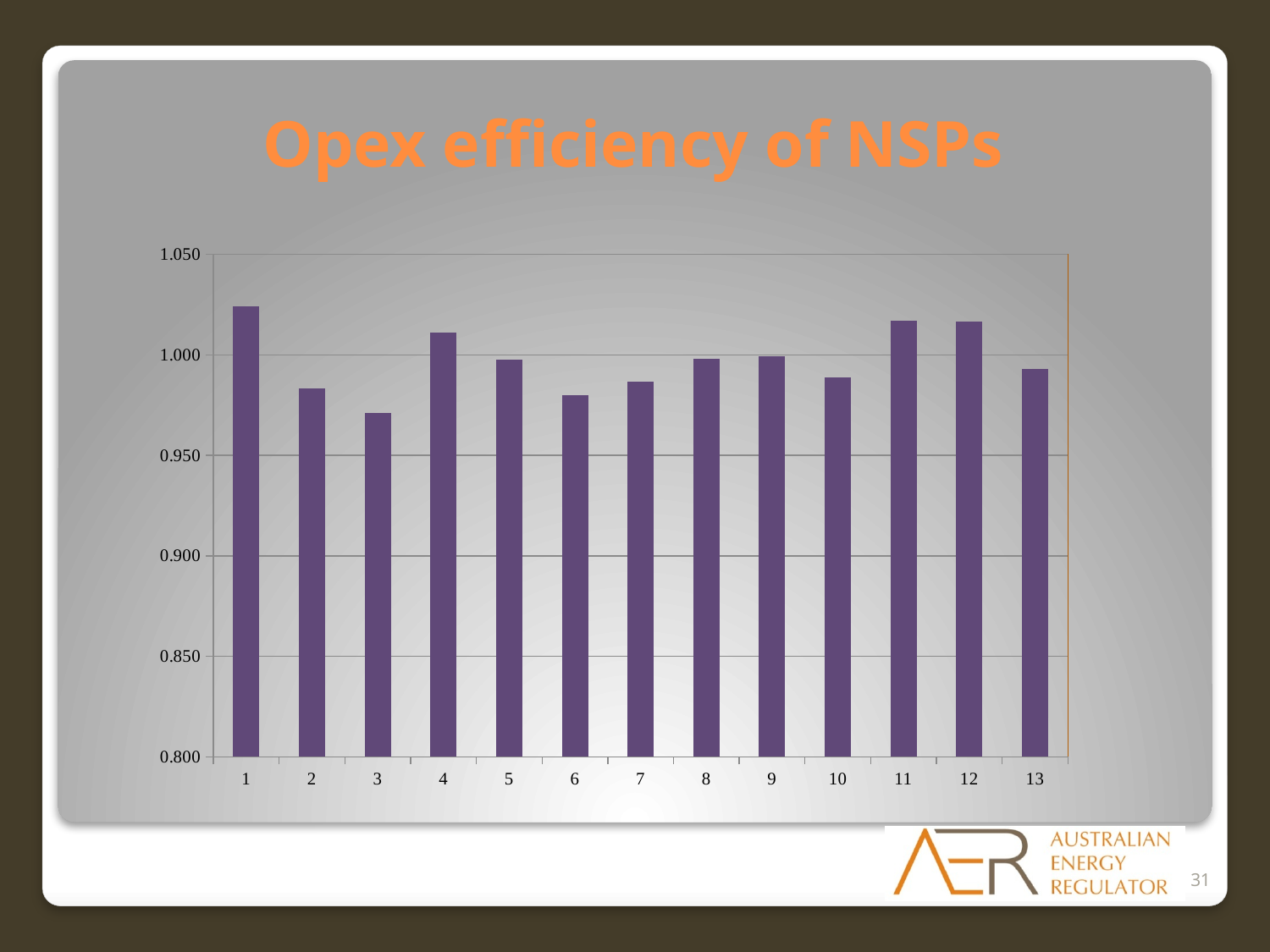
Which category has the highest value? 1 Is the value for category 6 greater or less than 1.000? less How many categories (bars) are plotted on the chart? 13 Is the value for category 11 greater or less than 1.000? greater What is the title of the chart? Opex efficiency of NSPs Is the value for category 3 greater or less than 1.000? less What is the lowest value shown on the vertical axis? 0.800 What kind of chart is shown on the slide? Bar chart Which has the larger value, category 12 or category 7? 12 Which has the larger value, category 4 or category 2? 4 Which category has the lowest value? 3